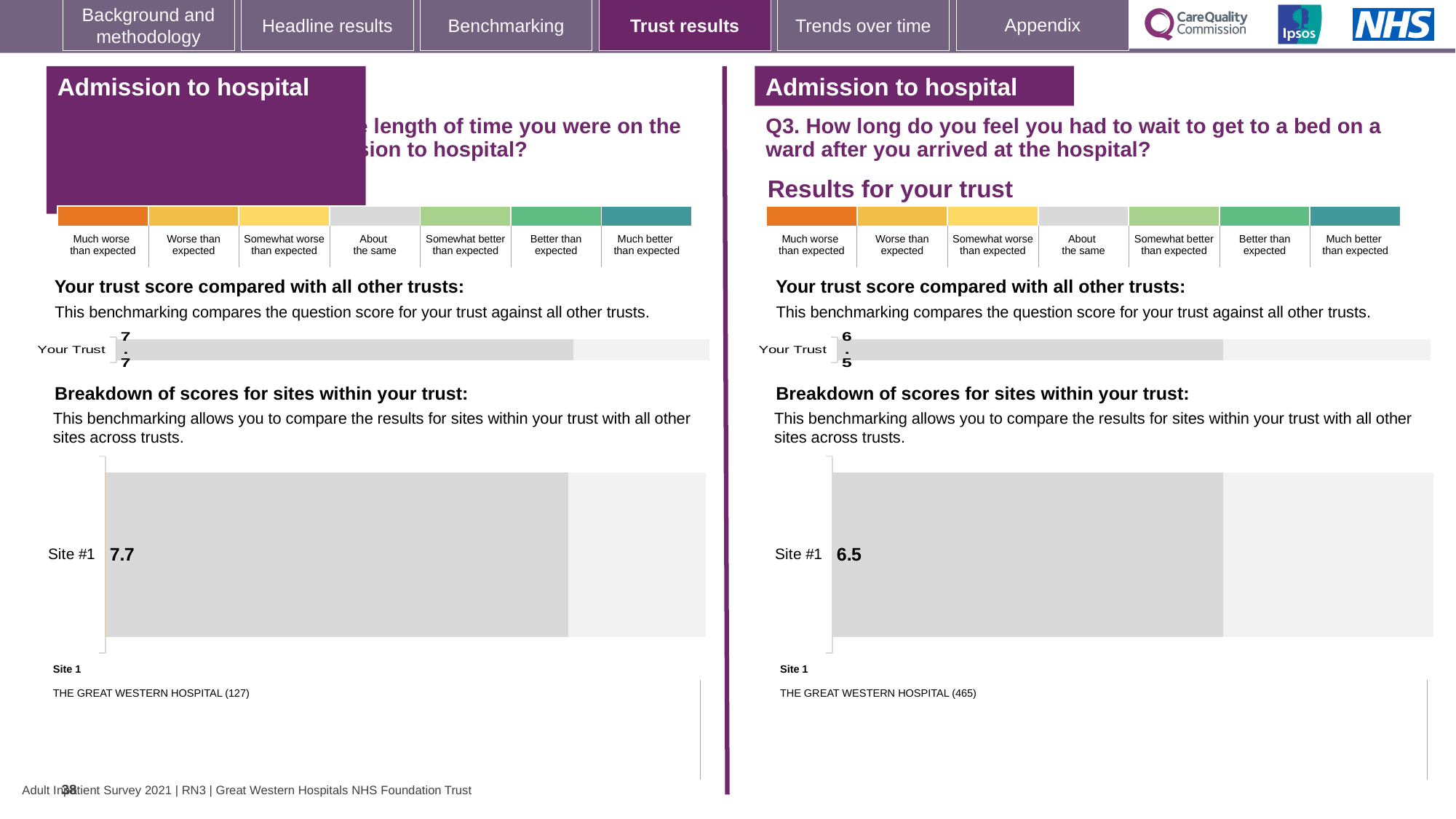
What kind of chart is used to show the 'Your Trust' score on the left half of the slide? Bar chart Which site name is listed as Site 1 beneath the breakdown chart on the left half of the slide? THE GREAT WESTERN HOSPITAL (127) On the left half of the slide, what is the score shown for 'Your Trust' in the 'Your trust score compared with all other trusts' chart? 7.7 In the 'Breakdown of scores for sites within your trust' chart on the right half of the slide (Q3), what is the value for Site #1? 6.5 How many sites are shown in the 'Breakdown of scores for sites within your trust' chart on the left half of the slide? 1 How many sites are shown in the 'Breakdown of scores for sites within your trust' chart on the right half of the slide? 1 In the 'Breakdown of scores for sites within your trust' chart on the left half of the slide, what is the value for Site #1? 7.7 On the right half of the slide (Q3), what is the score shown for 'Your Trust' in the 'Your trust score compared with all other trusts' chart? 6.5 What is the difference between the Site #1 score on the left half of the slide (7.7) and the Site #1 score on the right half (6.5)? 1.2 Which is larger: the Site #1 score in the left-hand breakdown chart or the Site #1 score in the right-hand (Q3) breakdown chart? The left-hand chart (7.7) Which site name is listed as Site 1 beneath the breakdown chart on the right half of the slide? THE GREAT WESTERN HOSPITAL (465) What kind of chart is used to show the Site #1 score on the right half of the slide? Bar chart